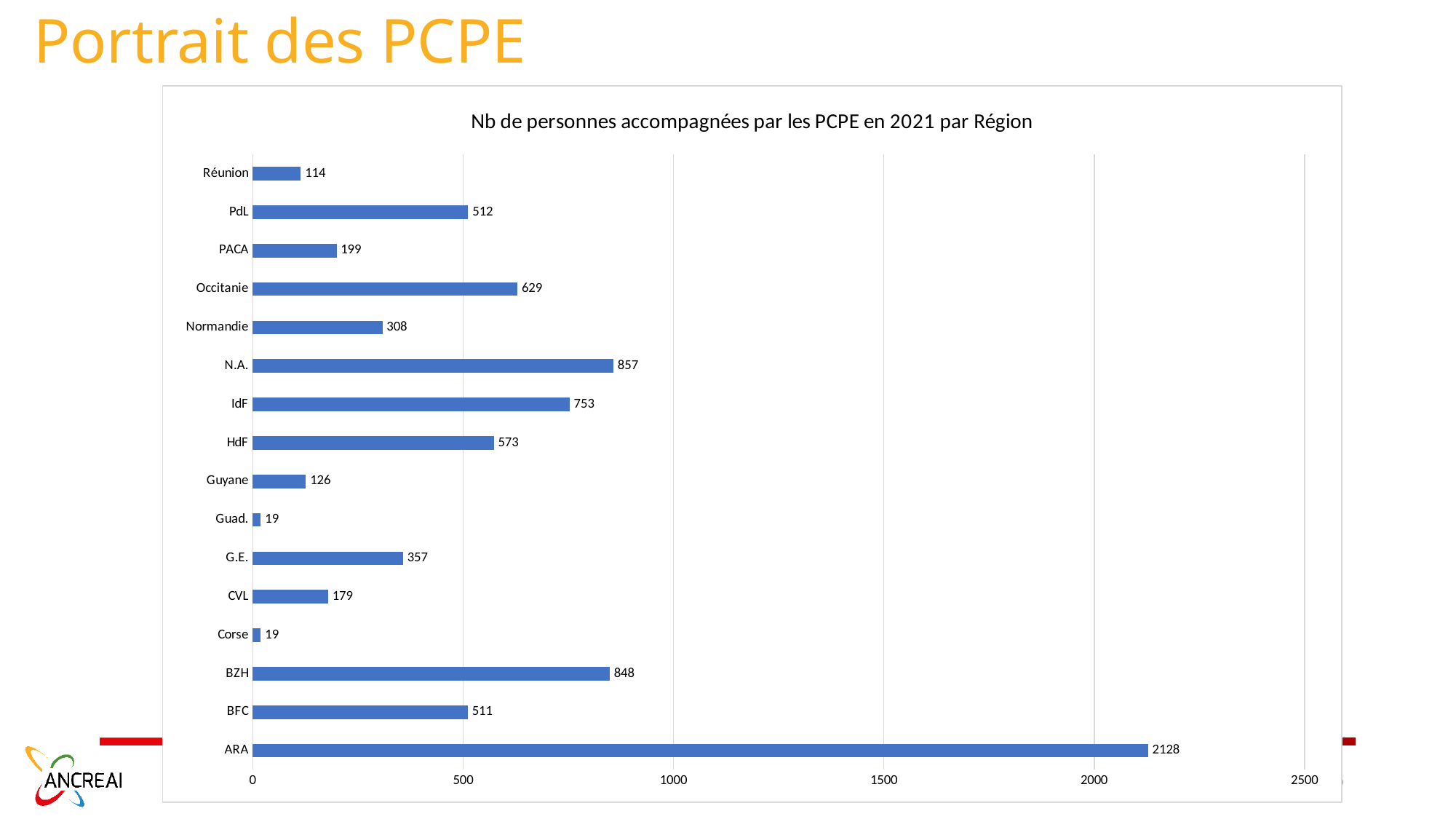
What is the difference between the values for IdF and HdF? 180 Which is larger, the value for BZH or the value for Occitanie? BZH Which regions share the lowest value of 19? Guad. and Corse How many regions are shown on the chart? 16 What is the value for Normandie? 308 What is the difference between the values for ARA and BZH? 1280 Which region has the highest number of people accompanied? ARA What is the value for N.A.? 857 What is the value for ARA? 2128 Is the value for PdL greater or less than 500? greater What kind of chart is this? Bar chart What is the title of the chart? Nb de personnes accompagnées par les PCPE en 2021 par Région